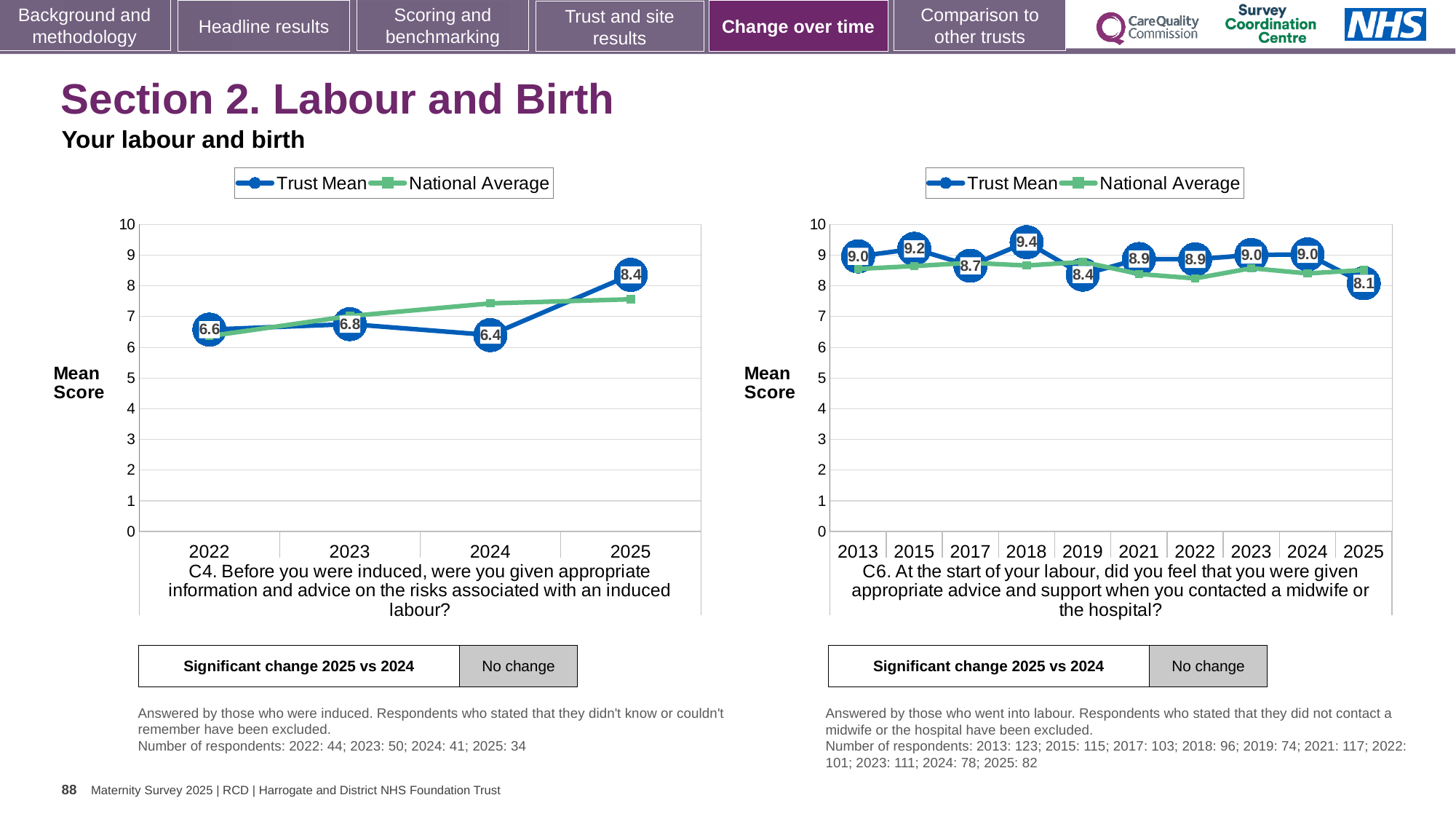
In the right chart (C6), which is larger, the Trust Mean for 2015 or for 2019? 2015 In the right chart (C6), which year has the lowest Trust Mean? 2025 In the left chart (C4), what is the difference between the Trust Mean in 2025 and in 2024? 2.0 In the left chart (C4), what is the Trust Mean for 2025? 8.4 In the left chart (C4), which year has the highest Trust Mean? 2025 In the left chart (C4), how many years are plotted on the x axis? 4 How many series does the legend of the right chart (C6) list? 2 In the left chart (C4), is the National Average for 2025 greater or less than 7? greater In the right chart (C6), how many years are plotted on the x axis? 10 In the right chart (C6), what is the Trust Mean for 2018? 9.4 What kind of chart is the left chart (C4)? Line chart In the left chart (C4), what is the Trust Mean for 2024? 6.4